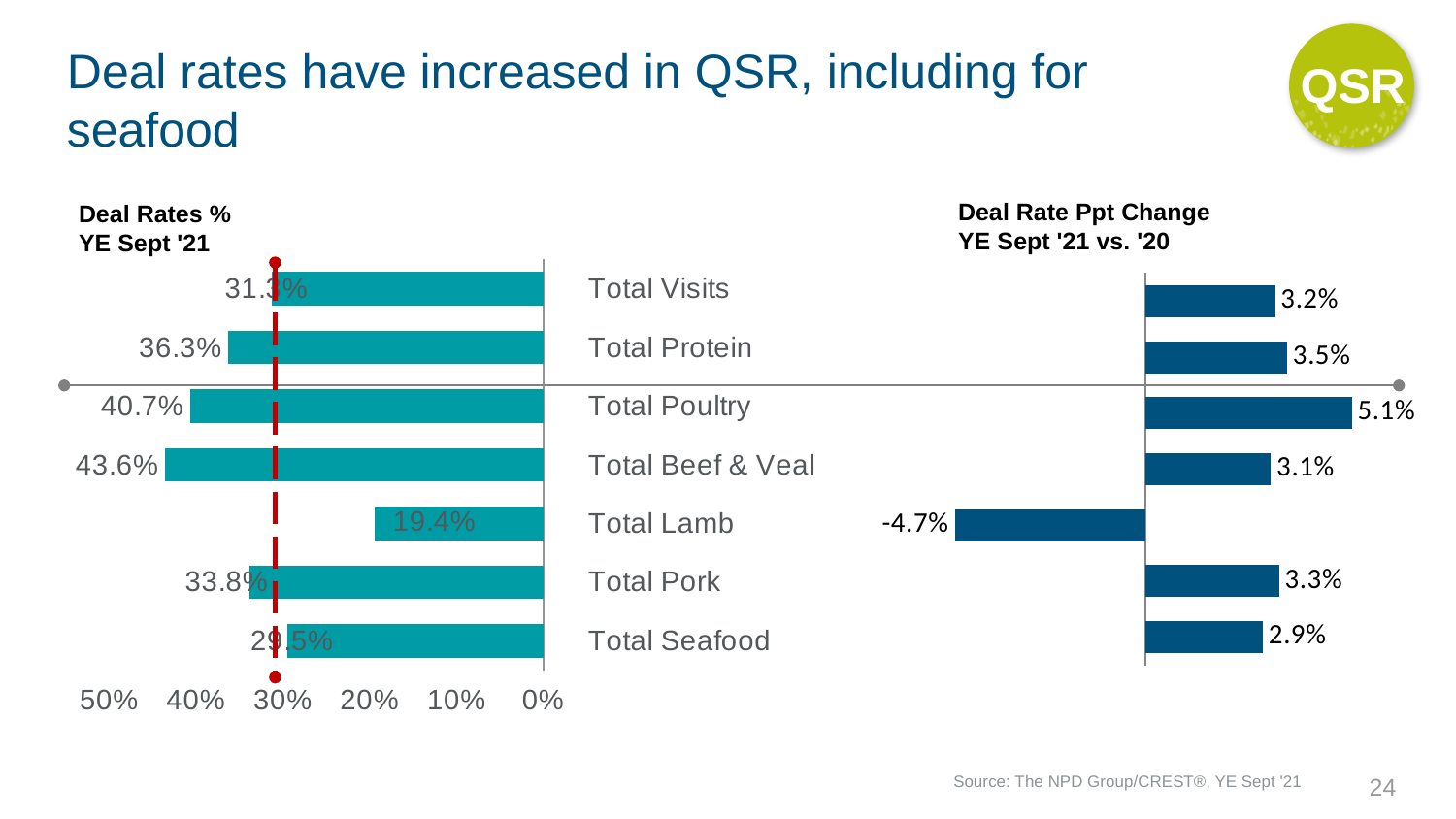
In the Deal Rate Ppt Change YE Sept '21 vs. '20 chart, which category has the largest change? Total Poultry How many categories are shown in the Deal Rates % YE Sept '21 chart? 7 In the Deal Rate Ppt Change YE Sept '21 vs. '20 chart, what is the difference between the values for Total Poultry and Total Seafood? 2.2% In the Deal Rates % YE Sept '21 chart, what is the deal rate for Total Beef & Veal? 43.6% In the Deal Rate Ppt Change YE Sept '21 vs. '20 chart, what is the value for Total Lamb? -4.7% In the Deal Rates % YE Sept '21 chart, which is larger, the deal rate for Total Poultry or for Total Protein? Total Poultry In the Deal Rates % YE Sept '21 chart, which category has the highest deal rate? Total Beef & Veal In the Deal Rates % YE Sept '21 chart, what is the deal rate for Total Lamb? 19.4% In the Deal Rates % YE Sept '21 chart, which category has the lowest deal rate? Total Lamb In the Deal Rate Ppt Change YE Sept '21 vs. '20 chart, what is the value for Total Poultry? 5.1% In the Deal Rate Ppt Change YE Sept '21 vs. '20 chart, which category has the lowest change? Total Lamb In the Deal Rates % YE Sept '21 chart, what is the difference between the deal rates for Total Beef & Veal and Total Lamb? 24.2%